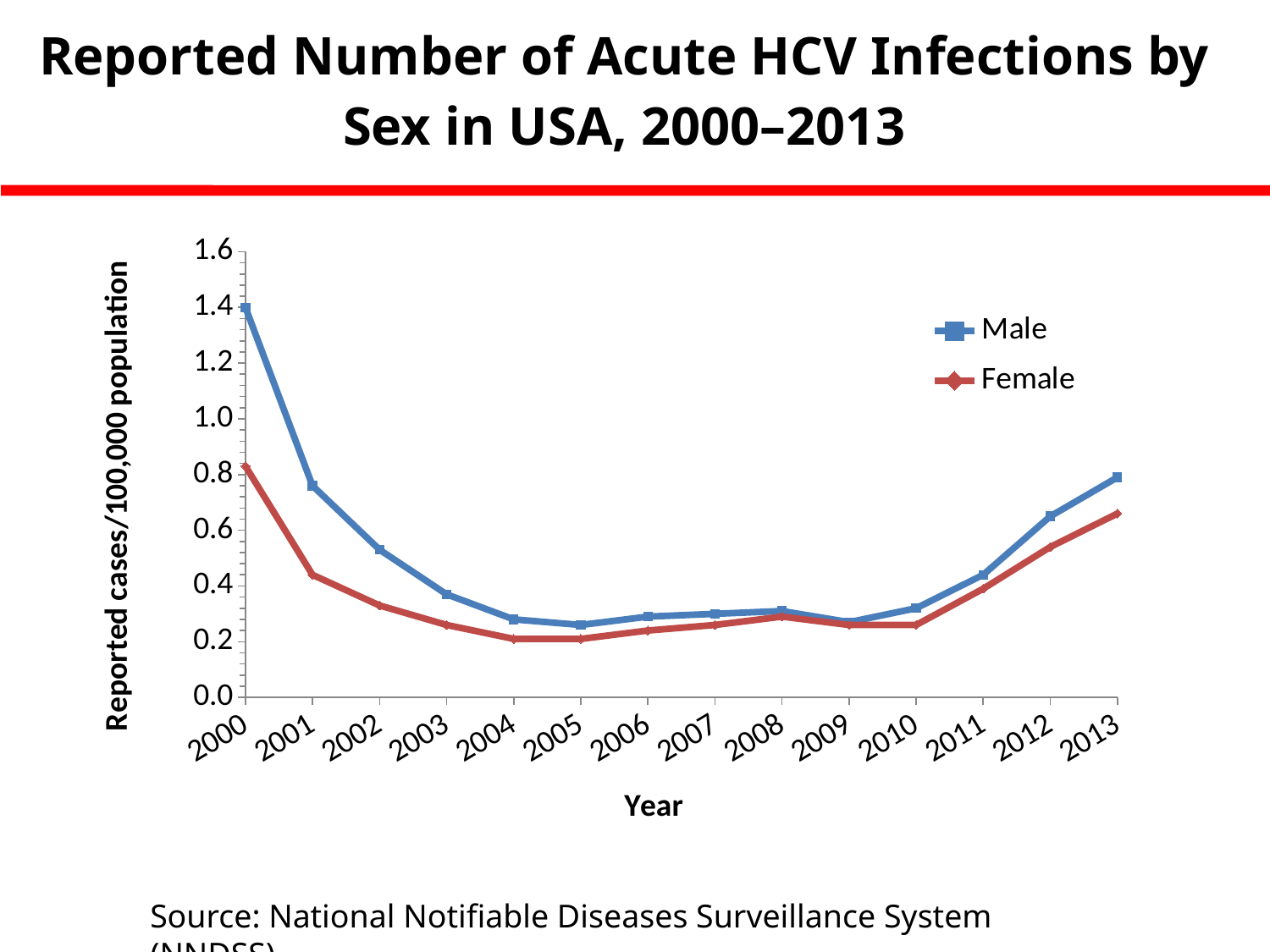
Is the Male value for 2000 greater or less than 1.2? greater Is the Male value for 2013 greater or less than 1.0? less In which year is the Female rate highest? 2000 How many years are plotted along the x axis? 14 In which year is the Male rate highest? 2000 Is the Male value for 2005 greater or less than 0.4? less What is the label on the y axis? Reported cases/100,000 population Do the Male values rise or fall from 2000 to 2005? Fall What kind of chart is shown on the slide? Line chart How many series does the legend list? 2 Which series has the larger value in 2000, Male or Female? Male